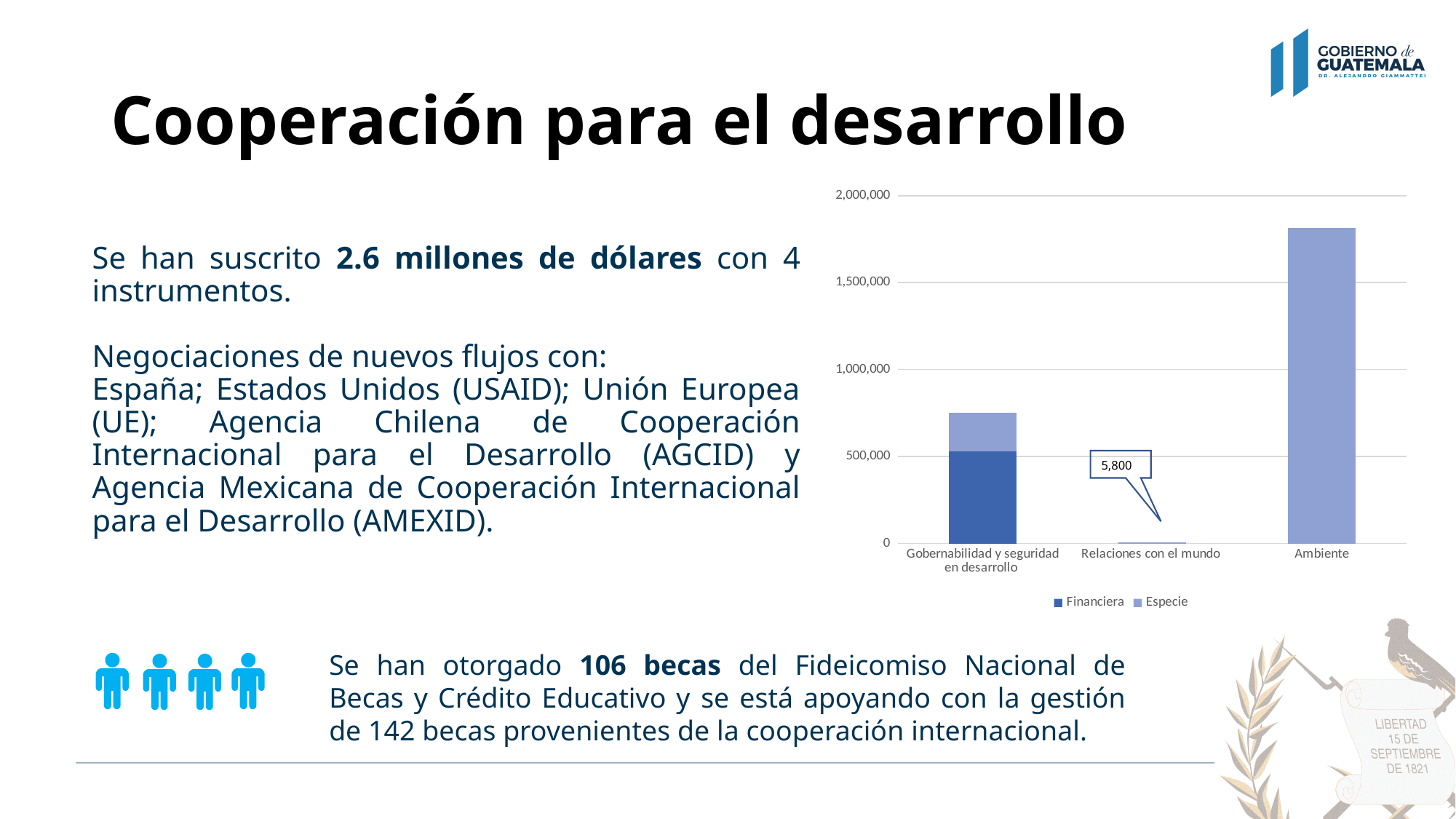
Is the value for Ambiente greater or less than 1,500,000? greater How many series does the chart legend list? 2 What value is labelled on the chart for Relaciones con el mundo? 5,800 Is the total stacked value for Gobernabilidad y seguridad en desarrollo greater or less than 500,000? greater How many categories are shown on the x axis of the chart? 3 What are the two series named in the chart legend? Financiera and Especie What kind of chart is shown on the slide? Bar chart Is the total stacked value for Gobernabilidad y seguridad en desarrollo greater or less than 1,000,000? less Which series is shown in the darker blue colour in the chart? Financiera Which is larger, the bar for Ambiente or the bar for Gobernabilidad y seguridad en desarrollo? Ambiente Which category has the tallest bar in the chart? Ambiente Which category has the smallest bar in the chart? Relaciones con el mundo